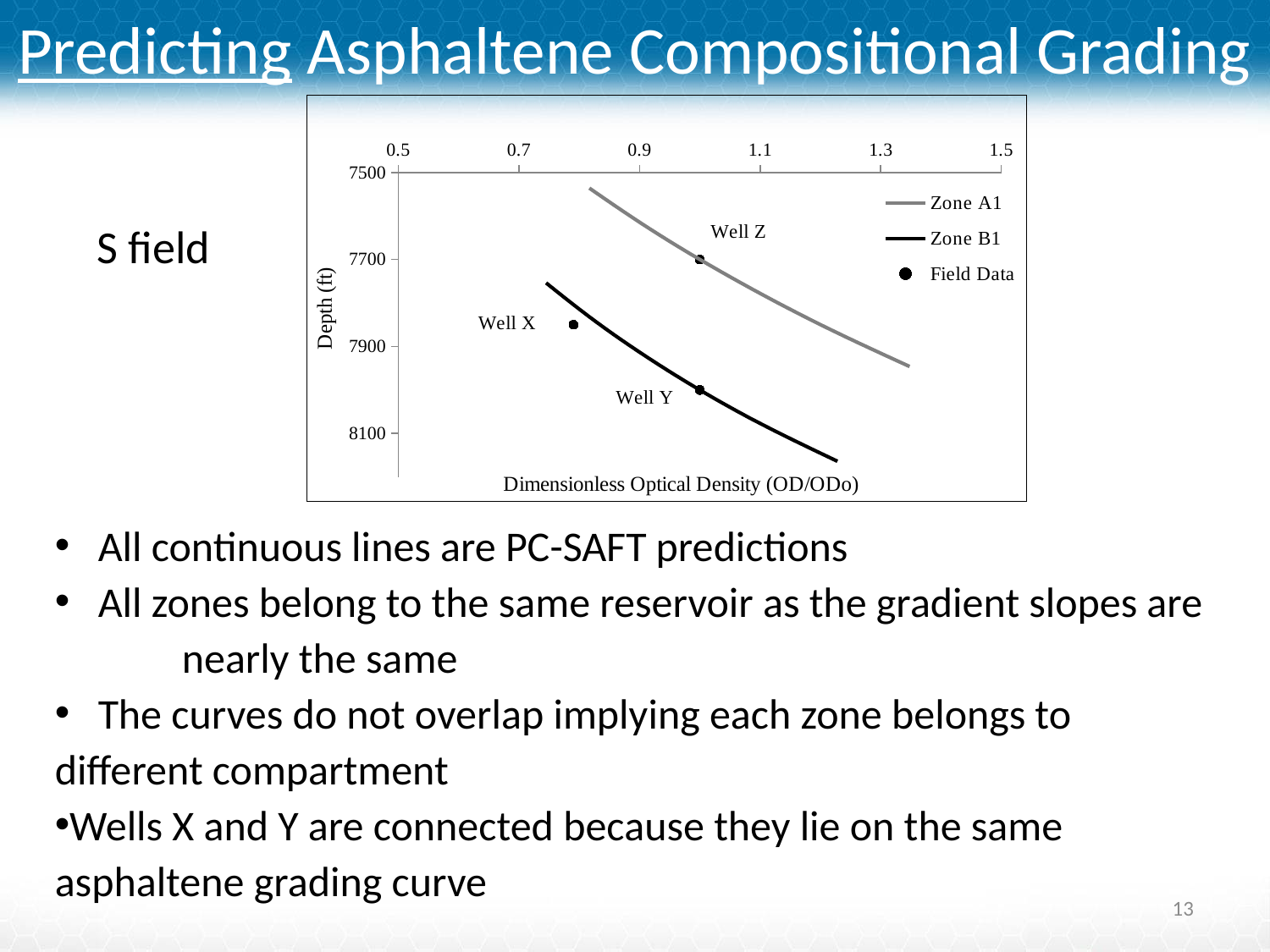
Along the Zone B1 curve, does depth increase or decrease as dimensionless optical density increases? increase Is the dimensionless optical density for Well X greater or less than 0.9? less Is the dimensionless optical density for Well Z greater or less than 0.9? greater What is the label of the x axis of the chart? Dimensionless Optical Density (OD/ODo) Is the depth for Well Z greater or less than 7900 ft? less How many field data points are plotted on the chart? 3 Which of the three wells is plotted at the greatest depth? Well Y How many entries does the chart legend list? 3 What kind of chart is shown on the slide? line chart Which zone is drawn with the gray line in the chart? Zone A1 Which has the larger dimensionless optical density, Well X or Well Z? Well Z